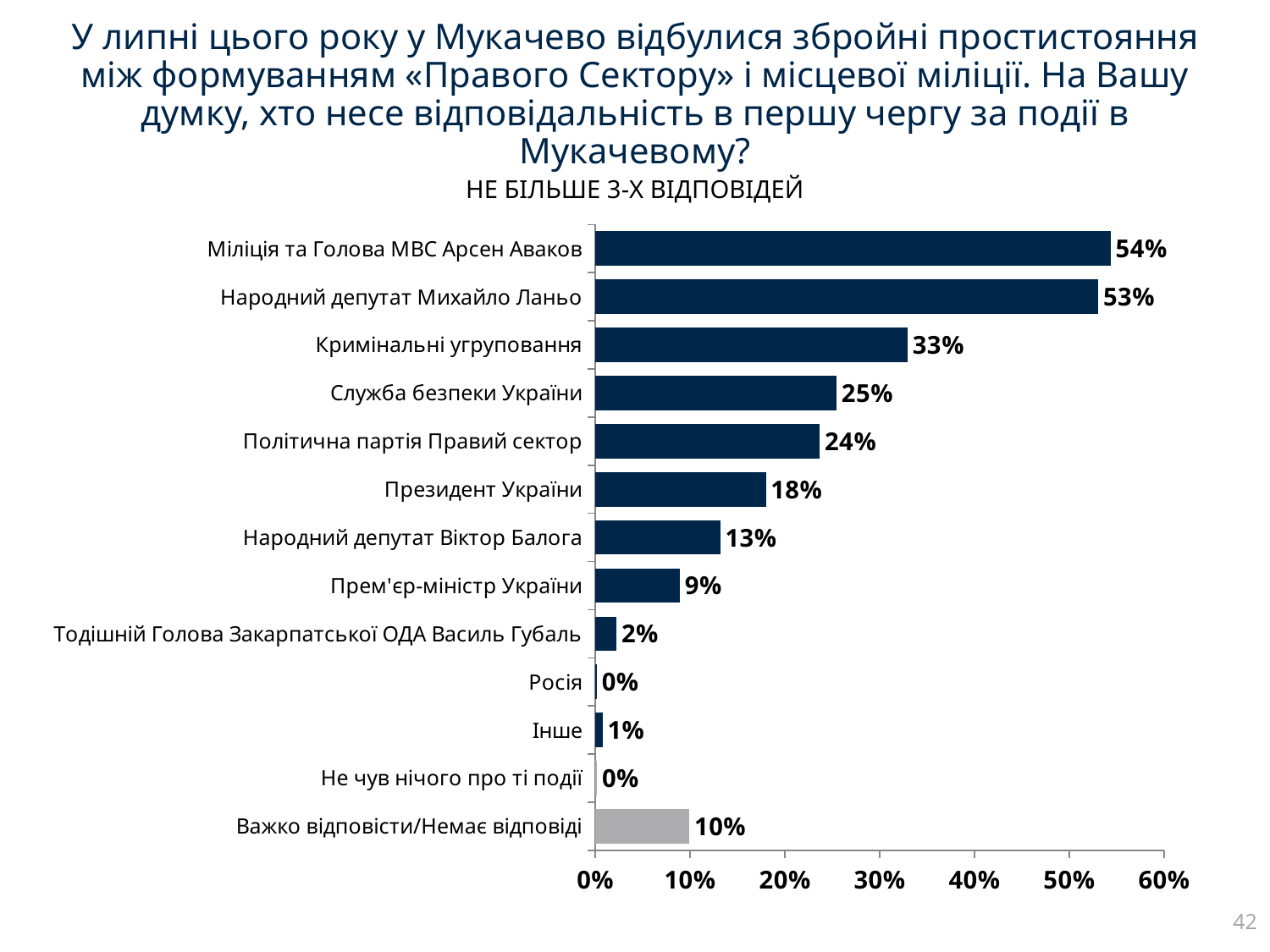
What is the value shown for Кримінальні угруповання? 33% How many categories are shown in the chart? 13 Which has a larger value: Служба безпеки України or Політична партія Правий сектор? Служба безпеки України What percentage is shown for Важко відповісти/Немає відповіді? 10% What is the value shown for Народний депутат Михайло Ланьо? 53% What is the value for Народний депутат Віктор Балога? 13% What kind of chart is shown on the slide? bar chart What percentage of respondents named Міліція та Голова МВС Арсен Аваков as responsible? 54% Is the value for Президент України greater or less than 20%? less Which category has the highest value in the chart? Міліція та Голова МВС Арсен Аваков What is the difference between the values for Міліція та Голова МВС Арсен Аваков and Кримінальні угруповання? 21 percentage points Which bar is shown in a different (grey) colour from the others? Важко відповісти/Немає відповіді